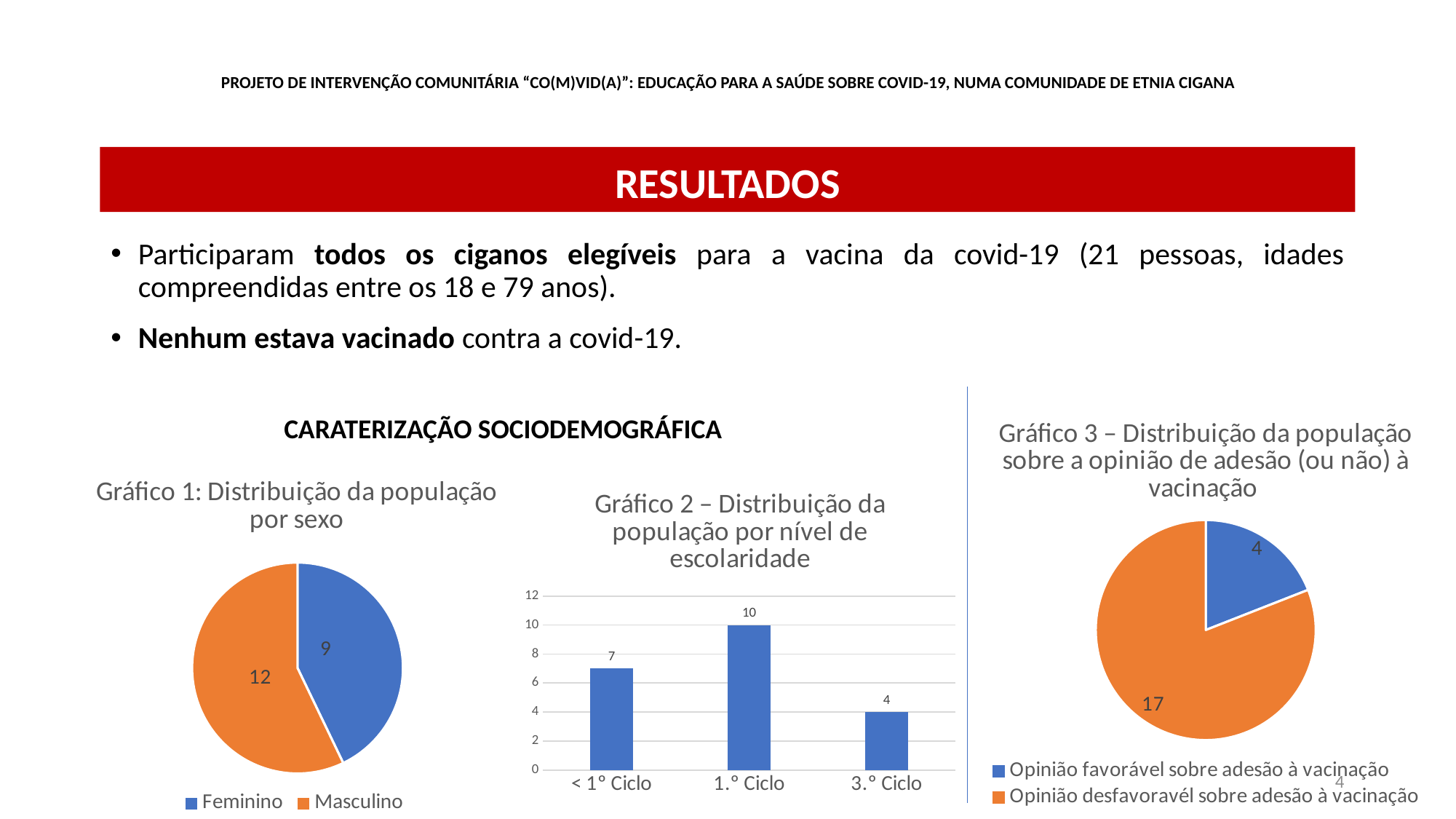
In Gráfico 3 (Distribuição da população sobre a opinião de adesão à vacinação), which colour represents Opinião favorável sobre adesão à vacinação? Blue In Gráfico 1 (Distribuição da população por sexo), what is the value for Masculino? 12 In Gráfico 2 (Distribuição da população por nível de escolaridade), how many categories are shown on the x axis? 3 In Gráfico 3 (Distribuição da população sobre a opinião de adesão à vacinação), what is the value for Opinião desfavorável sobre adesão à vacinação? 17 In Gráfico 3 (Distribuição da população sobre a opinião de adesão à vacinação), what is the difference between the desfavorável and favorável values? 13 In Gráfico 1 (Distribuição da população por sexo), what is the value for Feminino? 9 In Gráfico 1 (Distribuição da população por sexo), what is the total of the two slices? 21 What kind of chart is Gráfico 2 (Distribuição da população por nível de escolaridade)? Bar chart In Gráfico 1 (Distribuição da população por sexo), which category is larger, Feminino or Masculino? Masculino In Gráfico 2 (Distribuição da população por nível de escolaridade), what is the difference between the values for 1.° Ciclo and < 1° Ciclo? 3 In Gráfico 2 (Distribuição da população por nível de escolaridade), what is the value for 1.° Ciclo? 10 In Gráfico 2 (Distribuição da população por nível de escolaridade), which category has the lowest value? 3.° Ciclo